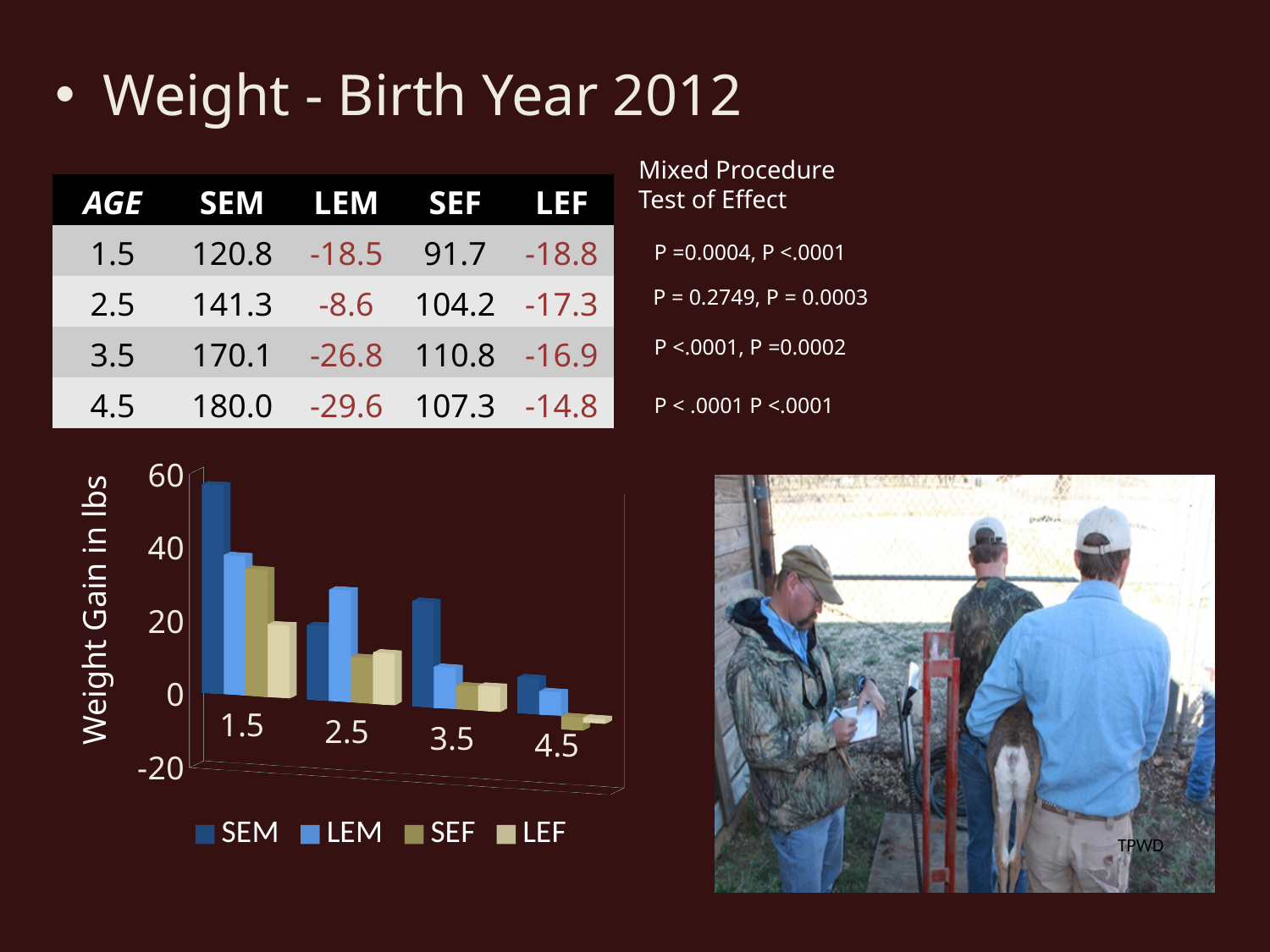
Is the SEM value for age 1.5 greater or less than 40? greater Is the LEM value for age 1.5 greater or less than 20? greater How many age categories are shown on the x axis of the chart? 4 What is the title of the vertical axis of the chart? Weight Gain in lbs Which series is shown in the darkest blue in the chart legend? SEM Is the SEM value for age 4.5 greater or less than 20? less How many series does the chart legend list? 4 Which series has the highest value at age 1.5? SEM What kind of chart is shown on the slide? bar chart At which age does the SEM series reach its highest value? 1.5